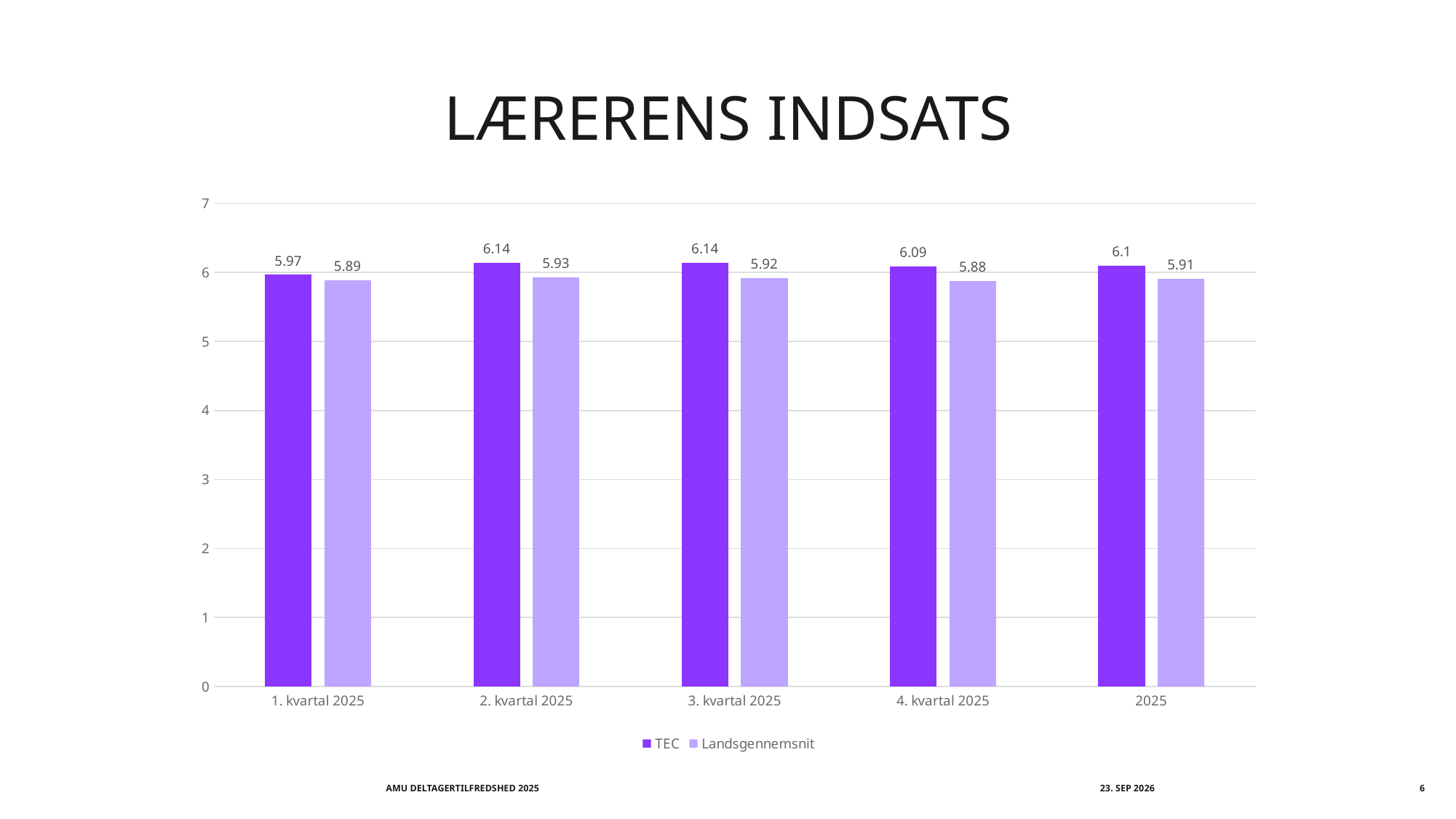
Which category has the lowest Landsgennemsnit value? 4. kvartal 2025 Which category has the lowest TEC value? 1. kvartal 2025 Which series is shown in the darker purple colour? TEC What is the difference between the TEC and Landsgennemsnit values for 3. kvartal 2025? 0.22 What kind of chart is shown on the slide? Bar chart What is the TEC value for 1. kvartal 2025? 5.97 How many categories are shown on the x axis? 5 What is the title of the chart? LÆRERENS INDSATS How many series does the legend list? 2 What is the Landsgennemsnit value for 4. kvartal 2025? 5.88 What is the TEC value for 2025? 6.1 Which is larger for 2. kvartal 2025, TEC or Landsgennemsnit? TEC